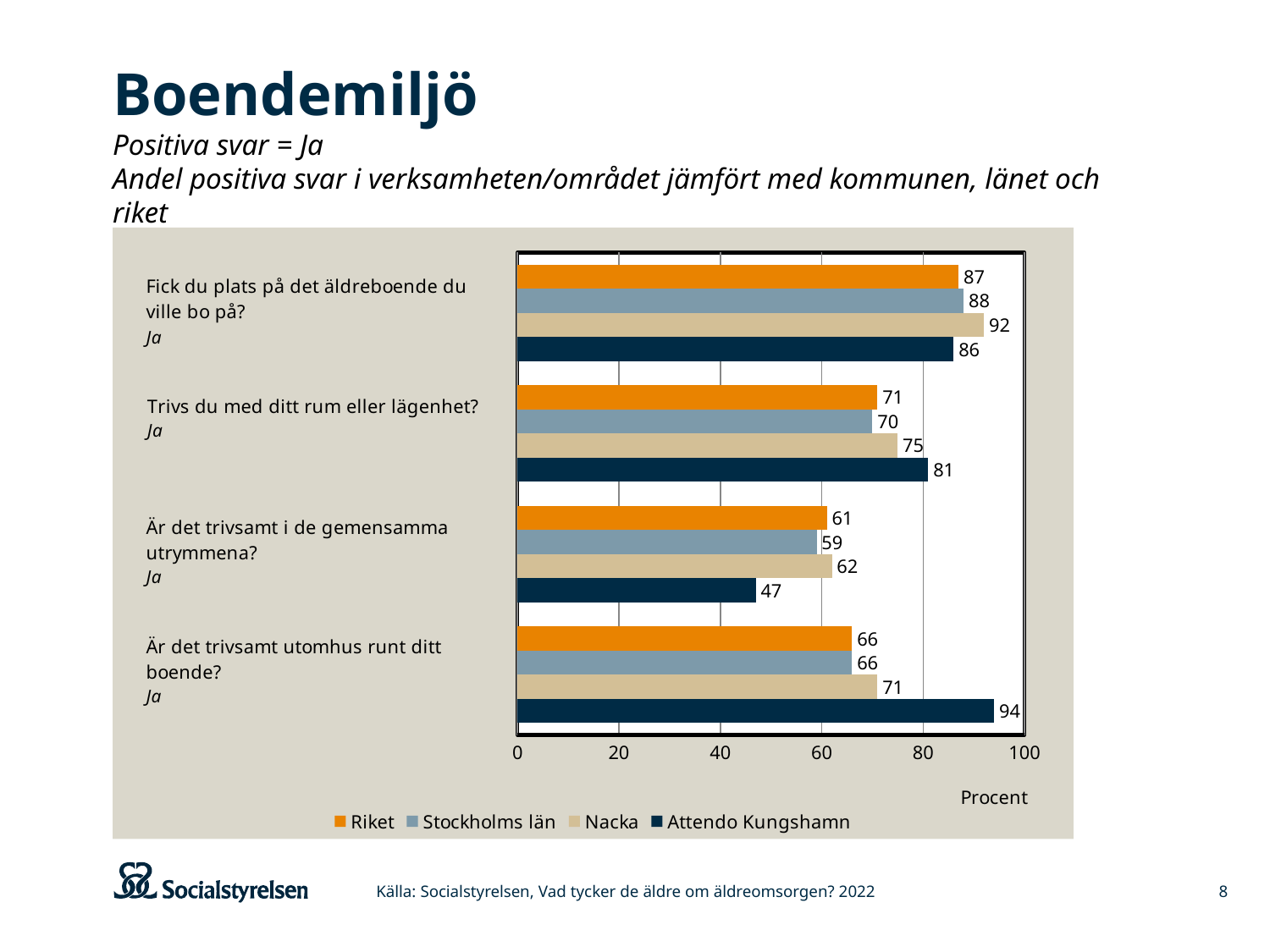
What unit is shown on the x axis of the chart? Procent What is the value for Nacka for "Fick du plats på det äldreboende du ville bo på?"? 92 What is the value for Stockholms län for "Trivs du med ditt rum eller lägenhet?"? 70 What is the value for Attendo Kungshamn for "Är det trivsamt utomhus runt ditt boende?"? 94 What kind of chart is shown on the slide? bar chart Which is larger for "Fick du plats på det äldreboende du ville bo på?": Riket or Attendo Kungshamn? Riket How many questions (categories) are shown on the chart? 4 How many series does the legend list? 4 Is the Attendo Kungshamn value for "Är det trivsamt i de gemensamma utrymmena?" greater or less than 60? less Which series has the lowest value for "Är det trivsamt i de gemensamma utrymmena?"? Attendo Kungshamn Which series has the highest value for "Trivs du med ditt rum eller lägenhet?"? Attendo Kungshamn What is the difference between the Attendo Kungshamn and Riket values for "Är det trivsamt utomhus runt ditt boende?"? 28